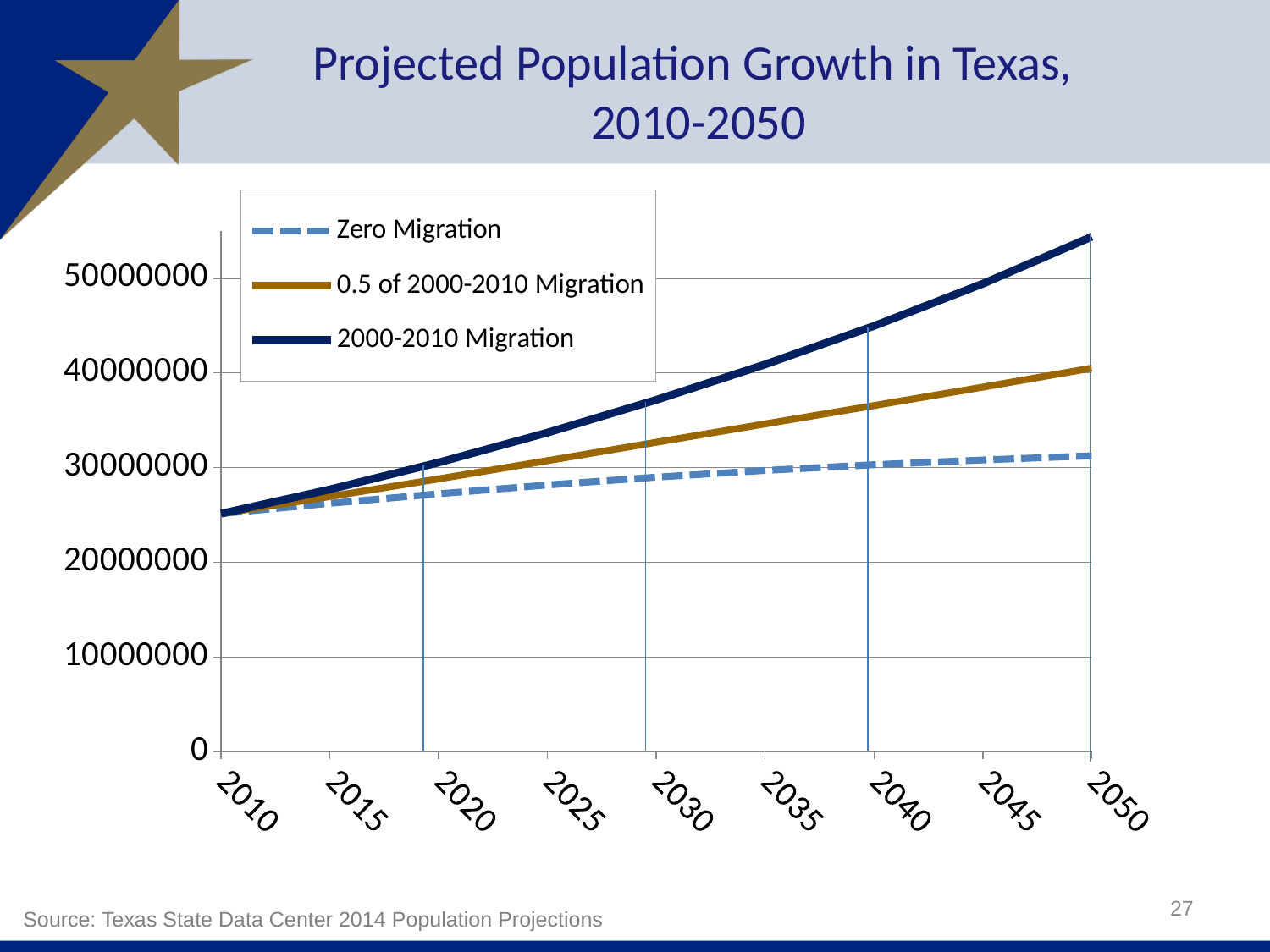
What is the title of the chart? Projected Population Growth in Texas, 2010-2050 What kind of chart is shown on the slide? line chart How many series does the legend list? 3 Is the value for 0.5 of 2000-2010 Migration in 2030 greater or less than 30000000? greater Is the value for Zero Migration in 2050 greater or less than 40000000? less Is the value for 2000-2010 Migration in 2050 greater or less than 50000000? greater In 2040, which is larger: the value for 2000-2010 Migration or the value for Zero Migration? 2000-2010 Migration Which series has the lowest value in 2050? Zero Migration Do the values for the 2000-2010 Migration series rise or fall from 2010 to 2050? rise Which series has the highest value in 2050? 2000-2010 Migration How many year labels are shown on the x axis? 9